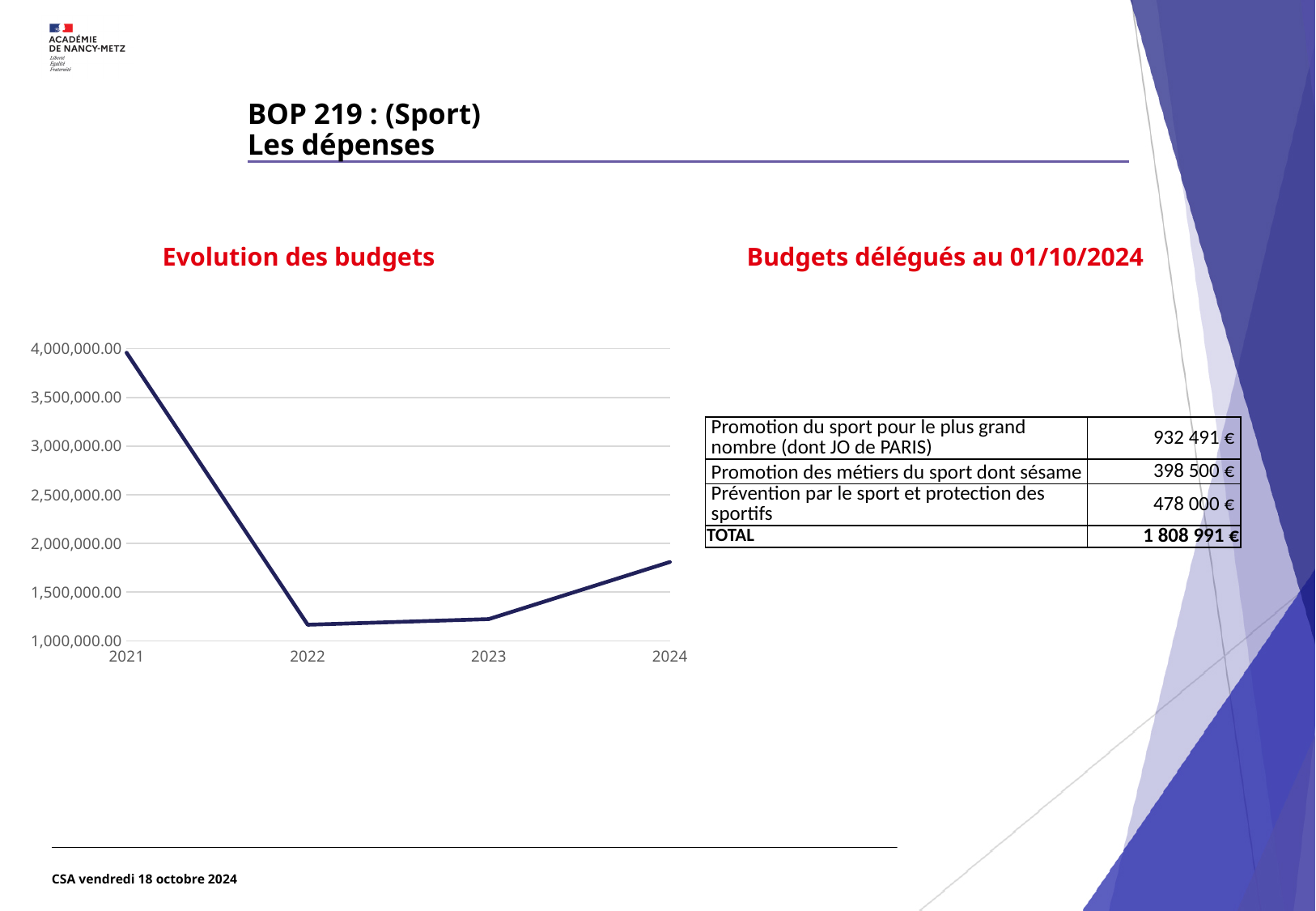
Is the value for 2024 in the 'Evolution des budgets' chart greater or less than 2,000,000.00? less How many years are plotted on the x axis of the 'Evolution des budgets' chart? 4 Does the line in the 'Evolution des budgets' chart rise or fall between 2023 and 2024? rise In the 'Evolution des budgets' chart, which is larger, the value for 2022 or the value for 2024? 2024 Which year has the highest value in the 'Evolution des budgets' chart? 2021 In the 'Evolution des budgets' chart, which is larger, the value for 2021 or the value for 2024? 2021 Is the value for 2021 in the 'Evolution des budgets' chart greater or less than 3,500,000.00? greater What is the lowest tick value shown on the y axis of the 'Evolution des budgets' chart? 1,000,000.00 What kind of chart is shown under the title 'Evolution des budgets'? line chart Is the value for 2024 in the 'Evolution des budgets' chart greater or less than 1,500,000.00? greater Does the line in the 'Evolution des budgets' chart rise or fall between 2021 and 2022? fall